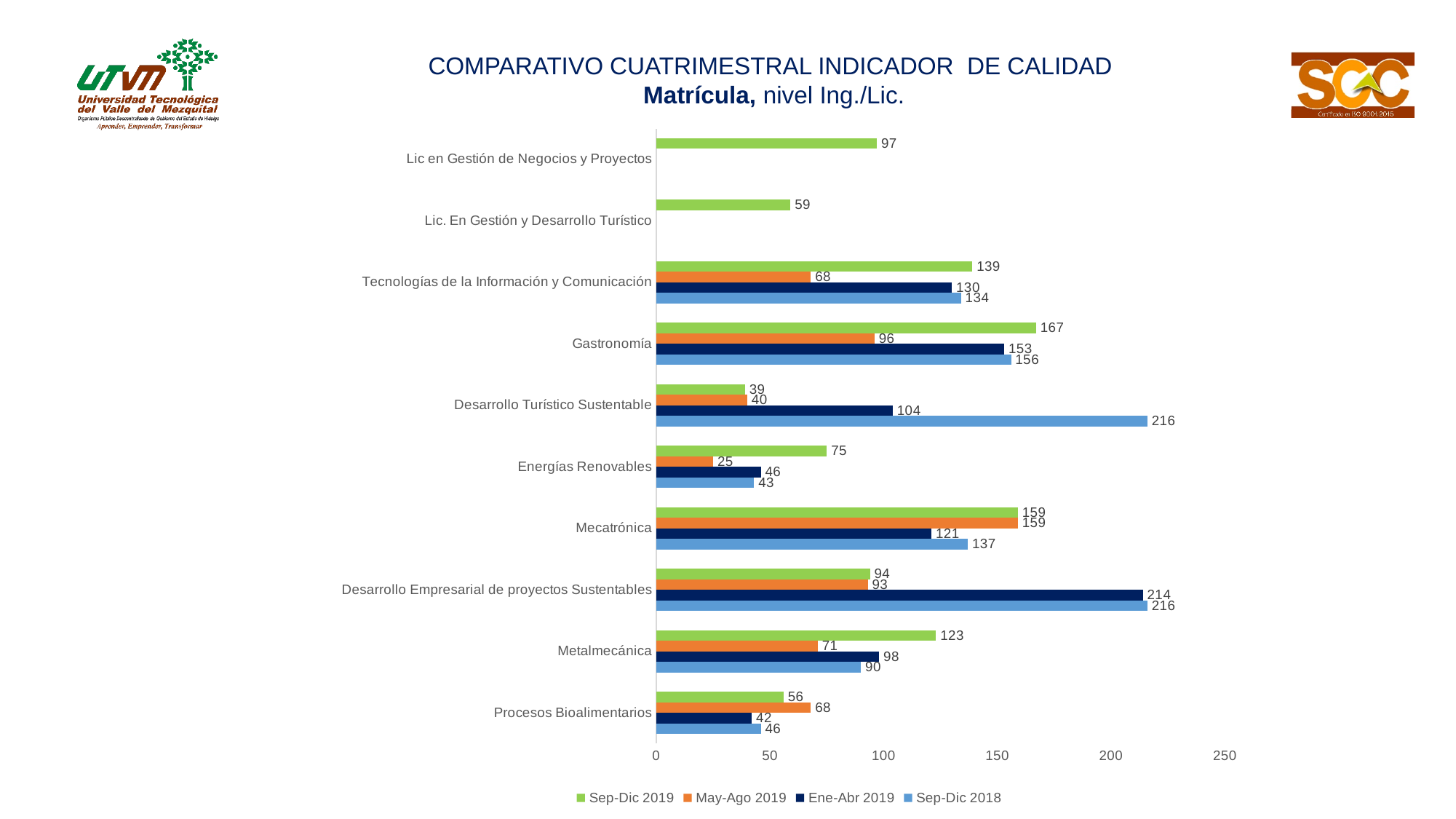
Which category has the lowest Sep-Dic 2019 value? Desarrollo Turístico Sustentable Which is larger for Metalmecánica: the Sep-Dic 2019 value or the May-Ago 2019 value? Sep-Dic 2019 What is the May-Ago 2019 value for Energías Renovables? 25 What is the Sep-Dic 2019 value for Gastronomía? 167 What is the difference between the Sep-Dic 2018 and Ene-Abr 2019 values for Desarrollo Turístico Sustentable? 112 How many series does the legend list? 4 How many categories are shown on the chart? 10 What is the Sep-Dic 2018 value for Desarrollo Turístico Sustentable? 216 What is the Ene-Abr 2019 value for Desarrollo Empresarial de proyectos Sustentables? 214 Which series is shown in orange in the legend? May-Ago 2019 Which category has the highest Sep-Dic 2019 value? Gastronomía What kind of chart is shown on the slide? Bar chart